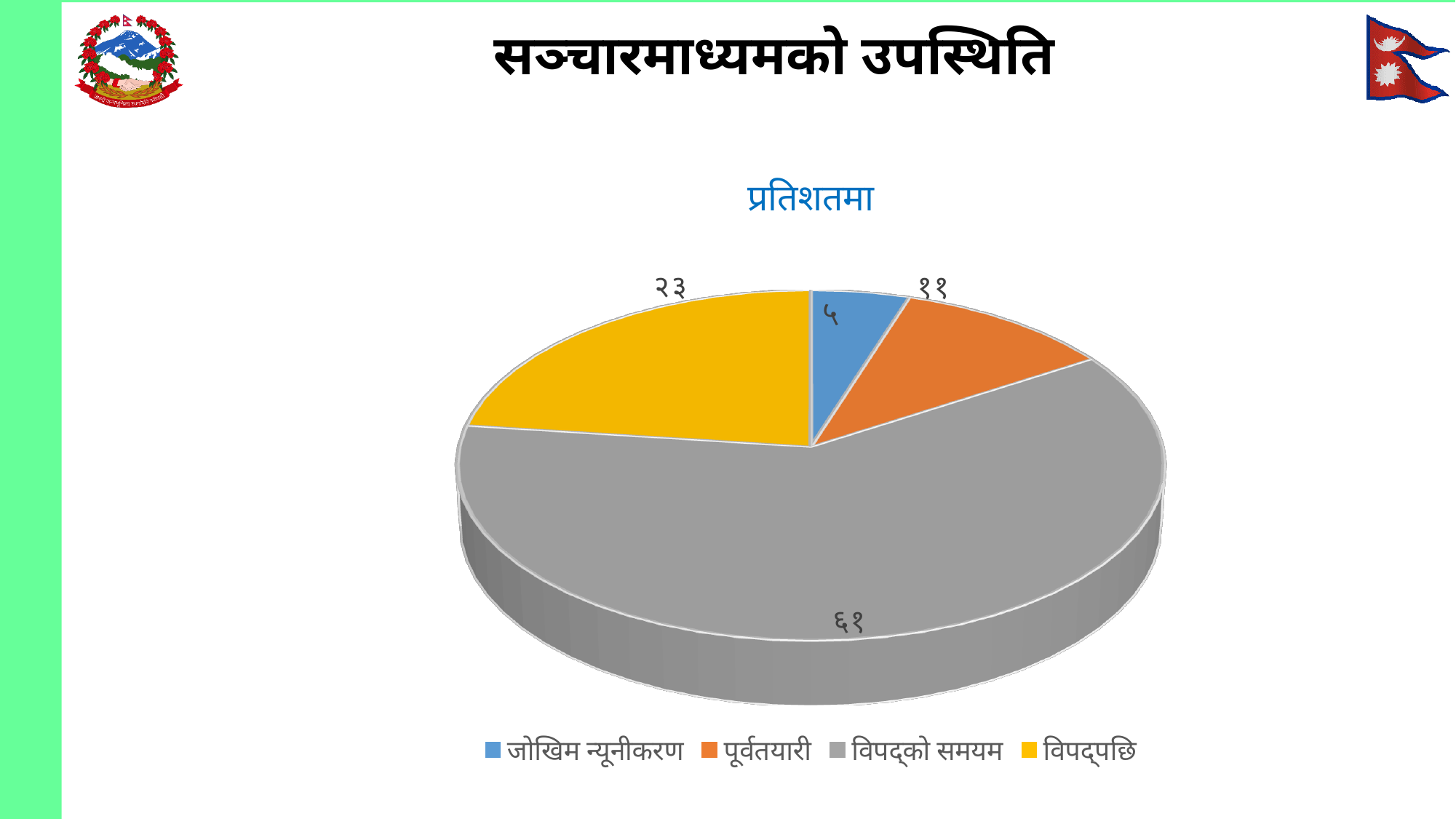
What is the value shown for विपद्पछि in the pie chart? २३ What is the value shown for जोखिम न्यूनीकरण in the pie chart? ५ What is the value shown for विपद्को समयम in the pie chart? ६१ What is the difference between the values for विपद्को समयम and विपद्पछि? ३८ How many categories does the pie chart show? 4 Which category has the smallest slice of the pie chart? जोखिम न्यूनीकरण Which category has the largest slice of the pie chart? विपद्को समयम Which is larger, the slice for विपद्पछि or the slice for पूर्वतयारी? विपद्पछि What is the difference between the values for पूर्वतयारी and जोखिम न्यूनीकरण? ६ What type of chart is shown on the slide? Pie chart What is the value shown for पूर्वतयारी in the pie chart? ११ What is the title of the chart? प्रतिशतमा